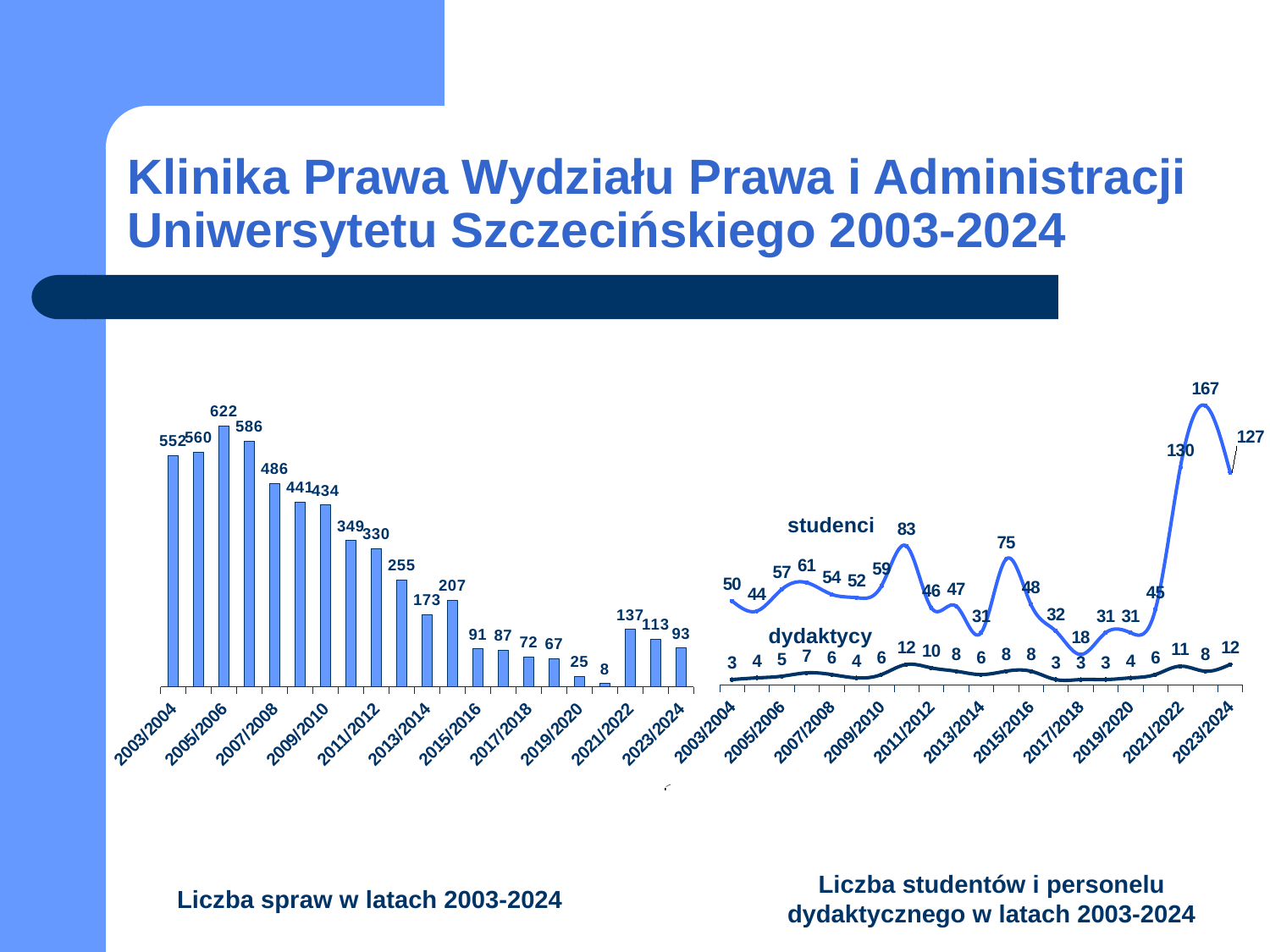
In the chart 'Liczba spraw w latach 2003-2024', what is the lowest value shown? 8 In the chart 'Liczba spraw w latach 2003-2024', what is the value for 2005/2006? 622 In the chart 'Liczba studentów i personelu dydaktycznego w latach 2003-2024', what is the highest studenci value? 167 What kind of chart is 'Liczba spraw w latach 2003-2024'? bar chart In the chart 'Liczba studentów i personelu dydaktycznego w latach 2003-2024', what is the studenci value for 2023/2024? 127 How many series are shown in the chart 'Liczba studentów i personelu dydaktycznego w latach 2003-2024'? 2 How many bars are in the chart 'Liczba spraw w latach 2003-2024'? 21 In the chart 'Liczba spraw w latach 2003-2024', what is the difference between the values for 2003/2004 and 2023/2024? 459 In the chart 'Liczba spraw w latach 2003-2024', do the values generally rise or fall from 2003/2004 to 2019/2020? fall In the chart 'Liczba studentów i personelu dydaktycznego w latach 2003-2024', which year has the larger studenci value, 2013/2014 or 2015/2016? 2015/2016 In the chart 'Liczba spraw w latach 2003-2024', which year has the highest value? 2005/2006 In the chart 'Liczba studentów i personelu dydaktycznego w latach 2003-2024', what is the dydaktycy value for 2011/2012? 10